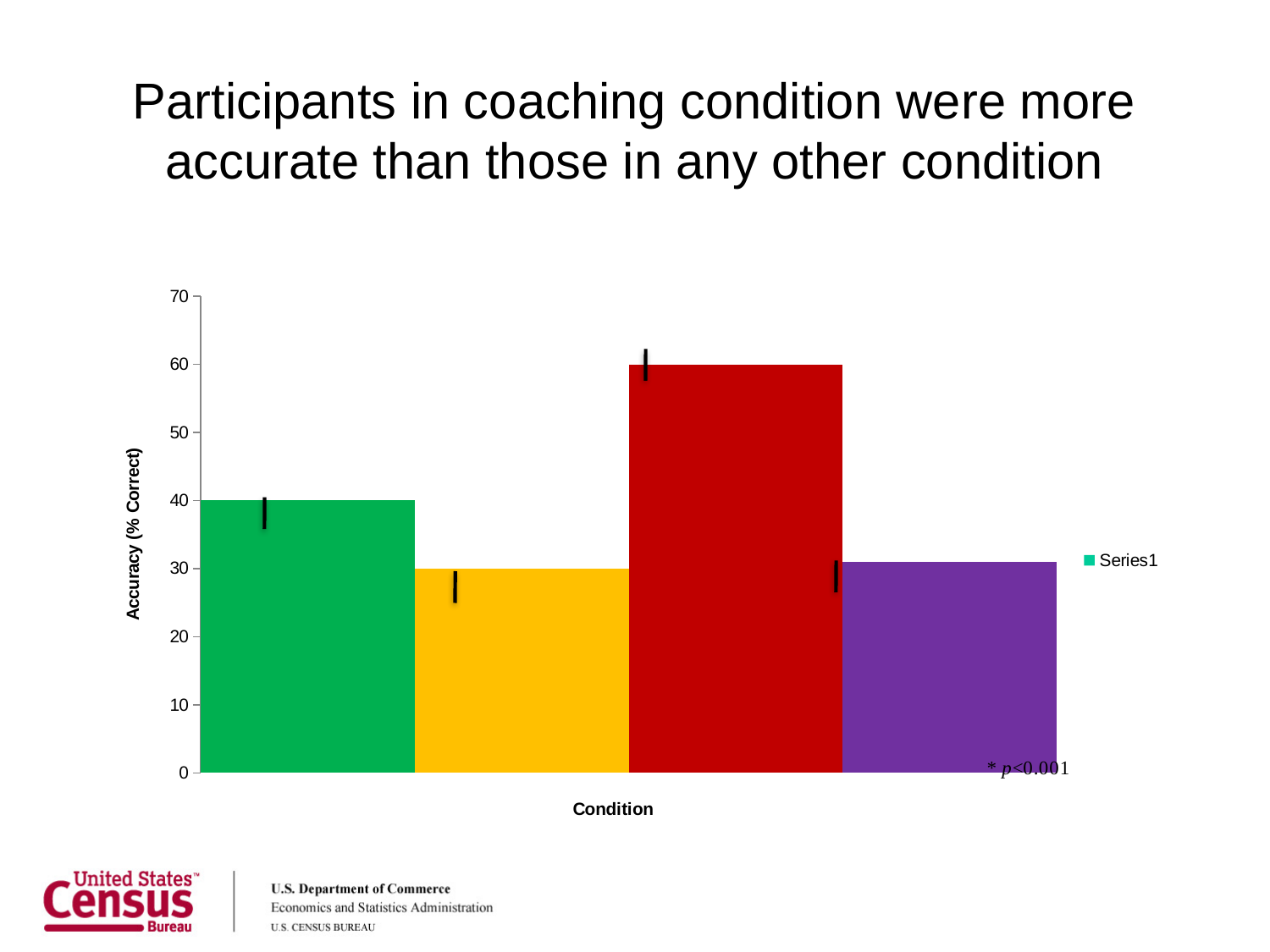
What kind of chart is shown on the slide? bar chart What is the label of the series shown in the legend? Series1 Which is larger, the red (third) bar or the green (first) bar? the red (third) bar Which is larger, the green (first) bar or the yellow (second) bar? the green (first) bar How many series does the legend list? 1 Is the value of the purple (fourth) bar greater or less than 20? greater How many bars are plotted in the chart? 4 Is the value of the red (third) bar greater or less than 50? greater What is the title of the vertical axis? Accuracy (% Correct) Which bar is the tallest in the chart? the red (third) bar Is the value of the yellow (second) bar greater or less than 40? less